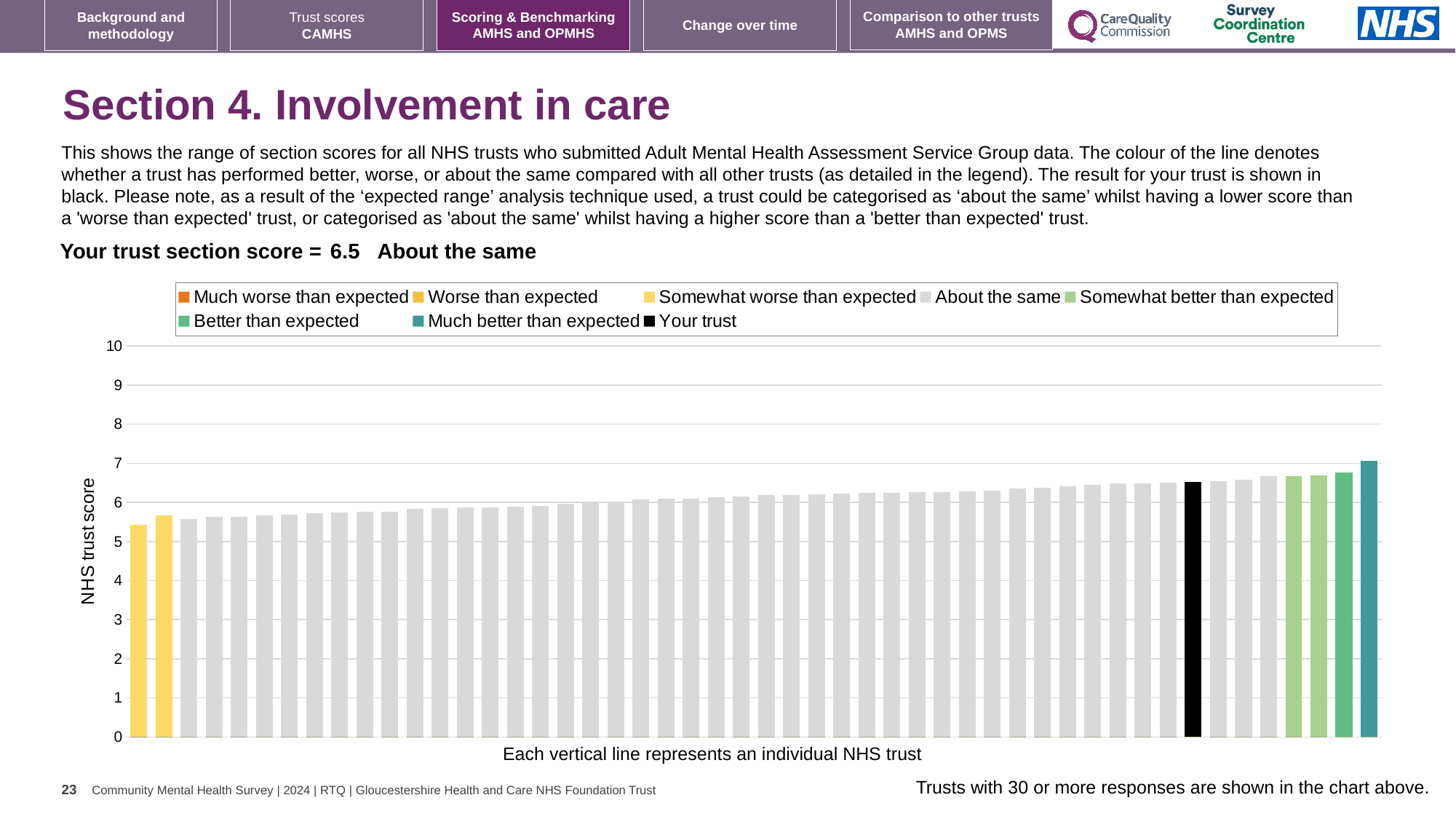
Which legend category does the lowest-scoring trust (leftmost bar) belong to? Somewhat worse than expected What kind of chart is shown on the slide? Bar chart What is the label on the vertical axis of the chart? NHS trust score Which performance category is your trust placed in for this section? About the same Which legend category does the highest-scoring trust (rightmost bar) belong to? Much better than expected Is the value of the rightmost (highest) bar greater or less than 6? greater Do the bar values rise or fall moving from left to right along the x axis? Rise What is the section score for your trust shown on the slide? 6.5 Is the value of the leftmost (lowest) bar greater or less than 6? less How many entries does the chart legend list? 8 Is the value of the black 'Your trust' bar greater or less than 6? greater